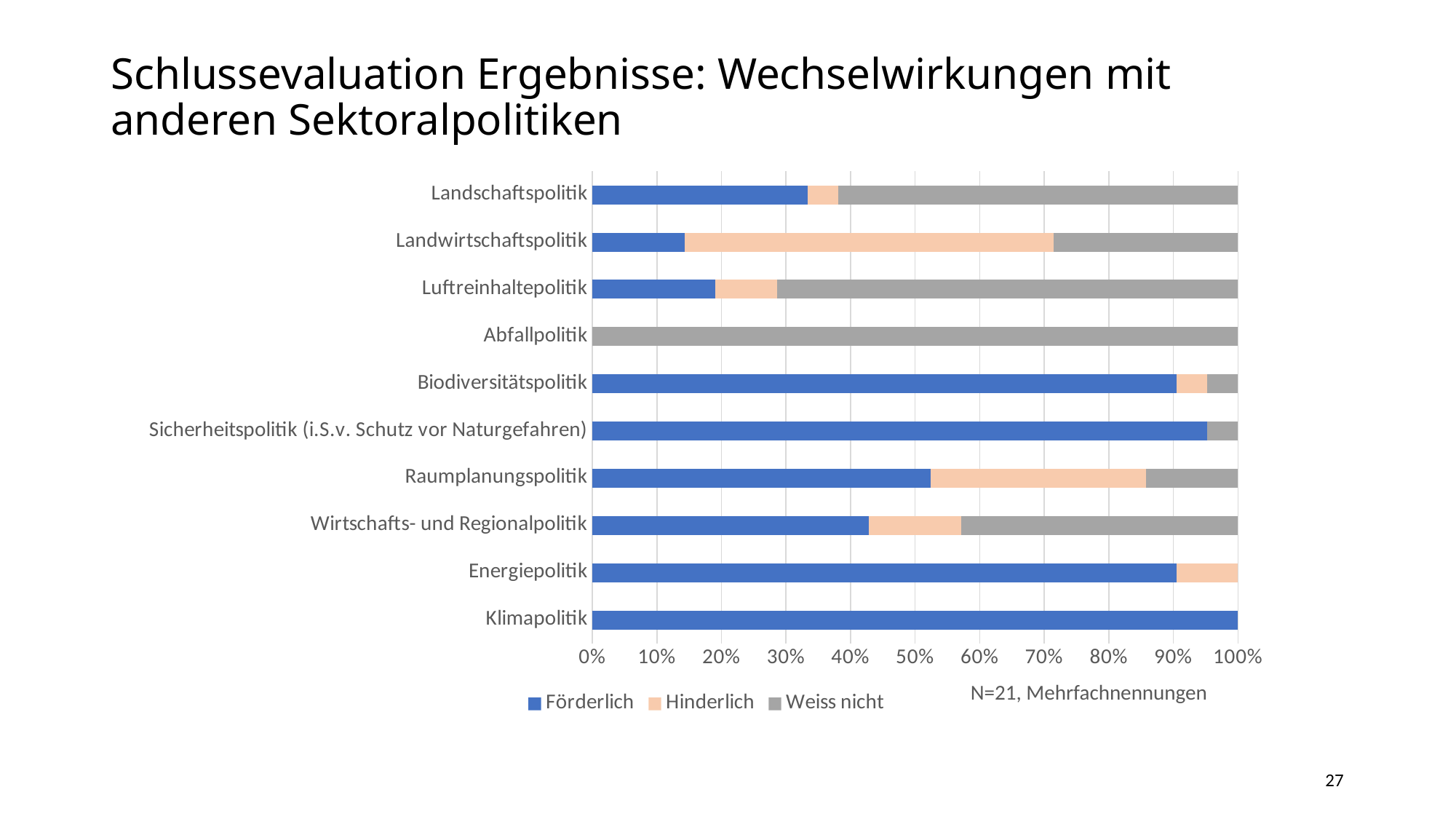
What is the Weiss nicht share for Abfallpolitik? 100% What sample size note is printed below the chart? N=21, Mehrfachnennungen Is the Förderlich share for Biodiversitätspolitik greater or less than 80%? greater What kind of chart is shown on the slide? Stacked bar chart Which category has the largest Hinderlich share? Landwirtschaftspolitik Which category has the highest Förderlich share? Klimapolitik Which category has the lowest Förderlich share? Abfallpolitik What is the Förderlich share for Klimapolitik? 100% How many policy categories are listed on the vertical axis of the chart? 10 Is the Förderlich share for Landwirtschaftspolitik greater or less than 20%? less How many series does the chart legend list? 3 Which has the larger Förderlich share, Landschaftspolitik or Landwirtschaftspolitik? Landschaftspolitik